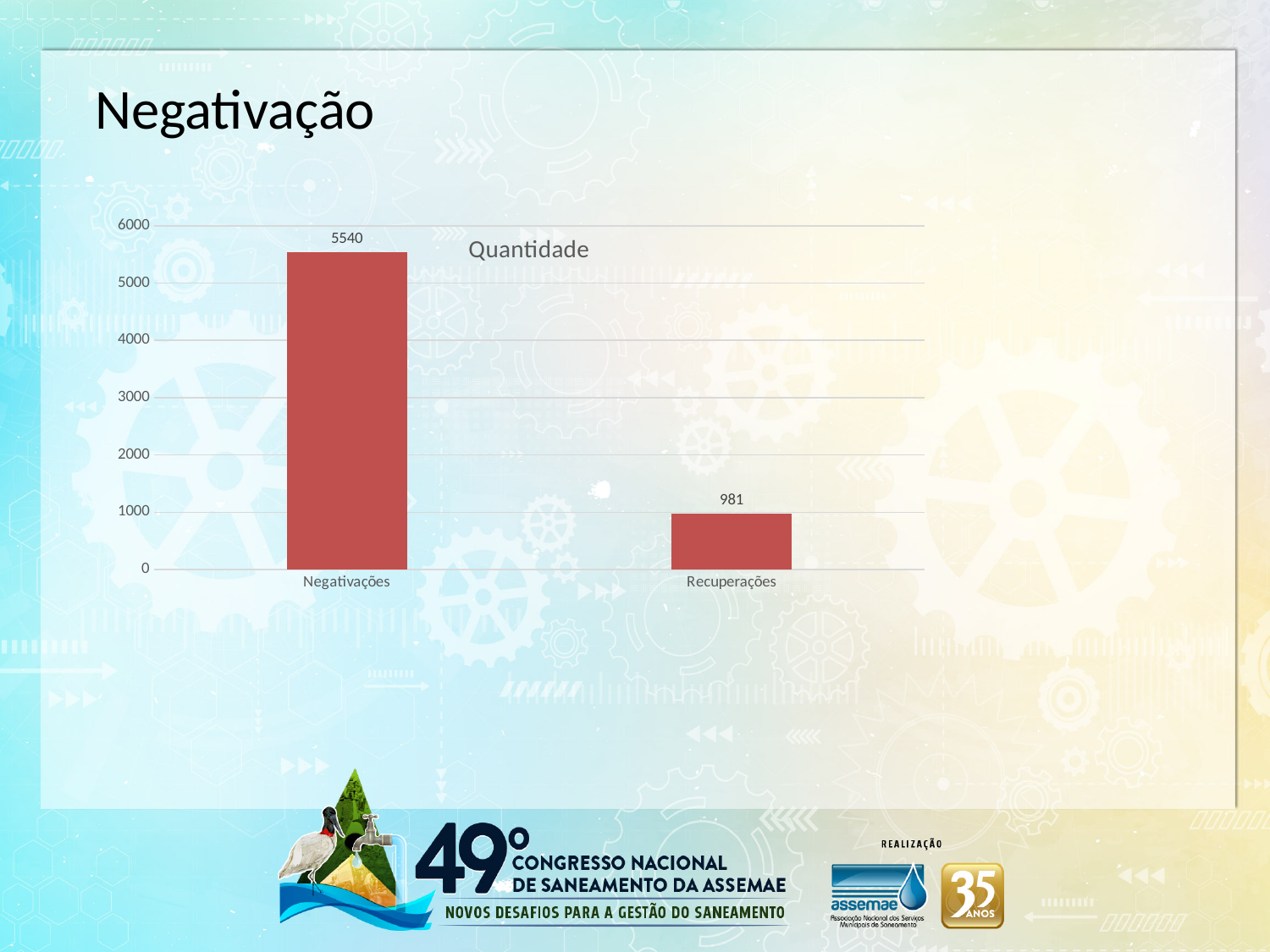
Is the value for Negativações greater or less than 5000? greater Which category has the lowest value? Recuperações What is the value for Negativações? 5540 What is the highest value shown on the vertical axis? 6000 What kind of chart is shown on the slide? bar chart How many categories are shown in the chart? 2 Which category has the highest value? Negativações What is the value for Recuperações? 981 Is the value for Recuperações greater or less than 1000? less What is the difference between the values for Negativações and Recuperações? 4559 Which is larger, the value for Negativações or the value for Recuperações? Negativações What is the title of the chart? Quantidade